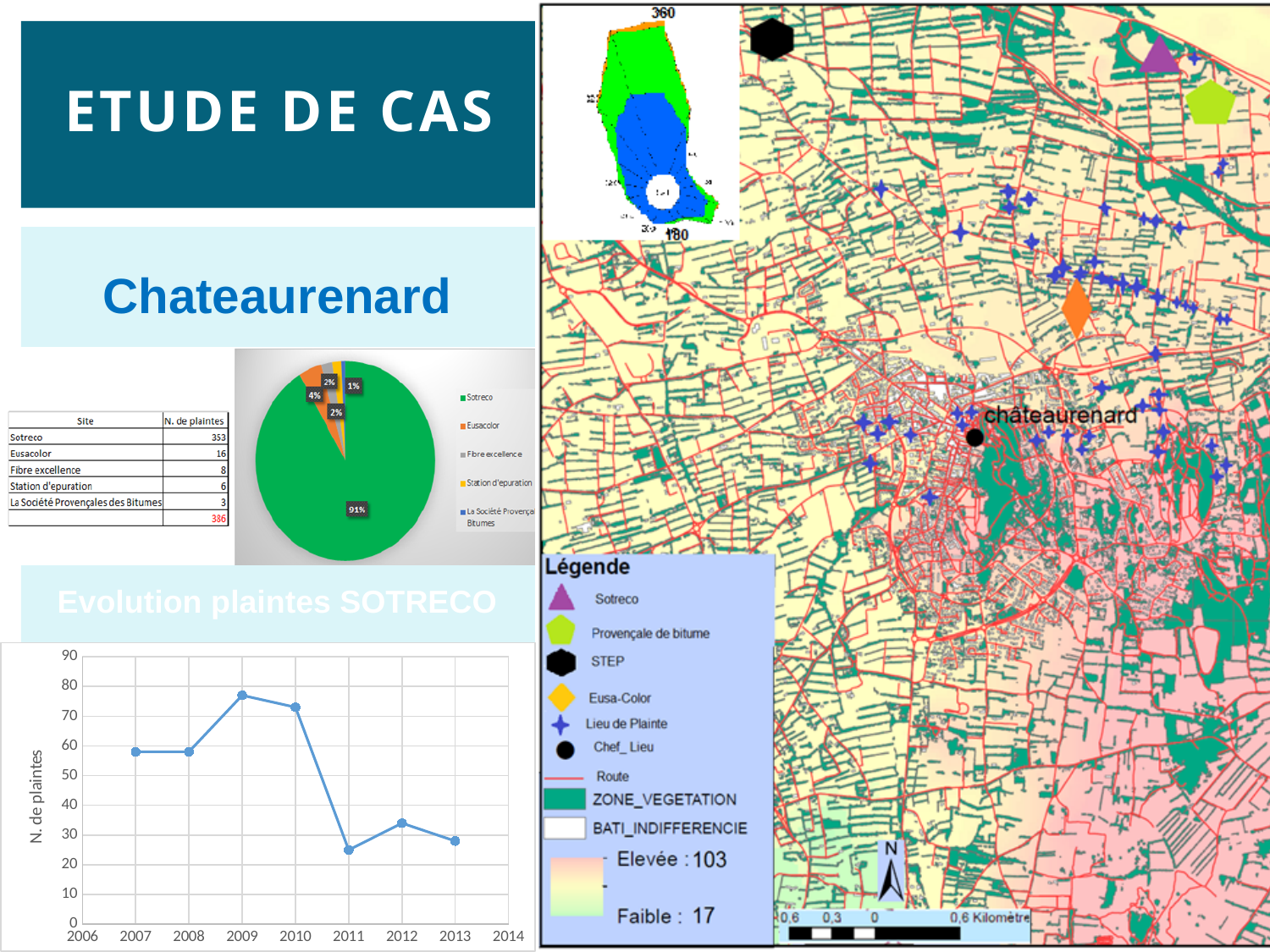
On the 'Evolution plaintes SOTRECO' chart, which year has the lowest number of complaints? 2011 On the pie chart, what share of the complaints does Sotreco account for? 91% What kind of chart is the one next to the table of sites? Pie chart On the pie chart, which site has the largest slice? Sotreco On the 'Evolution plaintes SOTRECO' chart, which year has the highest number of complaints? 2009 How many entries does the legend of the pie chart list? 5 On the pie chart, which site has the smallest slice? La Société Provençales des Bitumes On the pie chart, what share is shown for Eusacolor? 4% On the 'Evolution plaintes SOTRECO' chart, is the value for 2009 greater or less than 70? greater On the 'Evolution plaintes SOTRECO' chart, do the values rise or fall between 2010 and 2011? fall What kind of chart is 'Evolution plaintes SOTRECO'? Line chart On the 'Evolution plaintes SOTRECO' chart, is the value for 2011 greater or less than 30? less